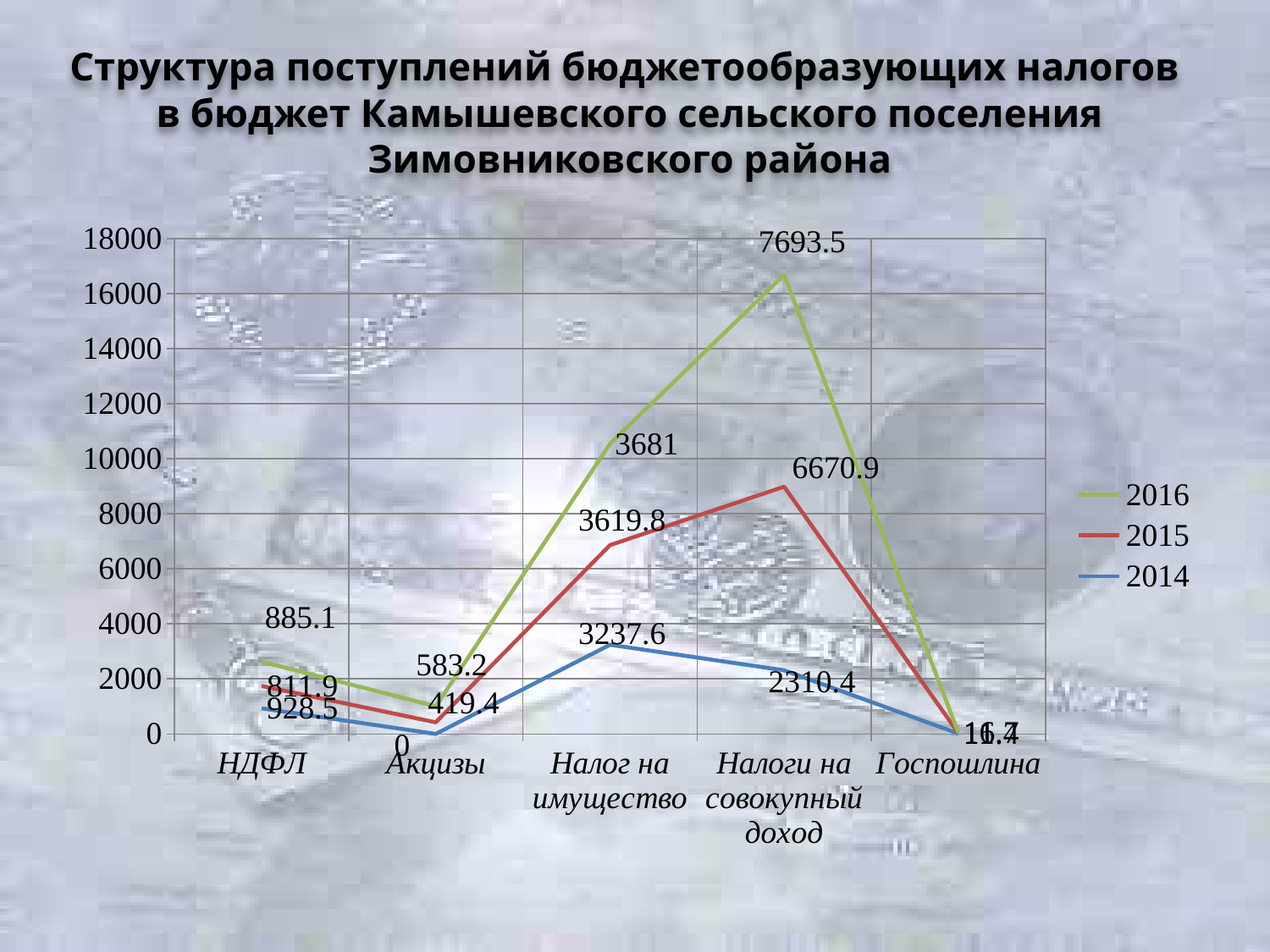
What type of chart is shown on the slide? line chart What is the value for НДФЛ in the 2015 series? 811.9 Which category has the highest value in the 2016 series? Налоги на совокупный доход What is the value for Налоги на совокупный доход in the 2015 series? 6670.9 What is the value for Налоги на совокупный доход in the 2016 series? 7693.5 How many categories are shown on the x axis? 5 What is the value for Налог на имущество in the 2014 series? 3237.6 For Акцизы, which is larger: the 2016 value or the 2015 value? 2016 Which years are listed in the legend? 2016, 2015, 2014 What is the value for Акцизы in the 2014 series? 0 How many series does the legend list? 3 What is the difference between the 2016 and 2015 values for Налоги на совокупный доход? 1022.6